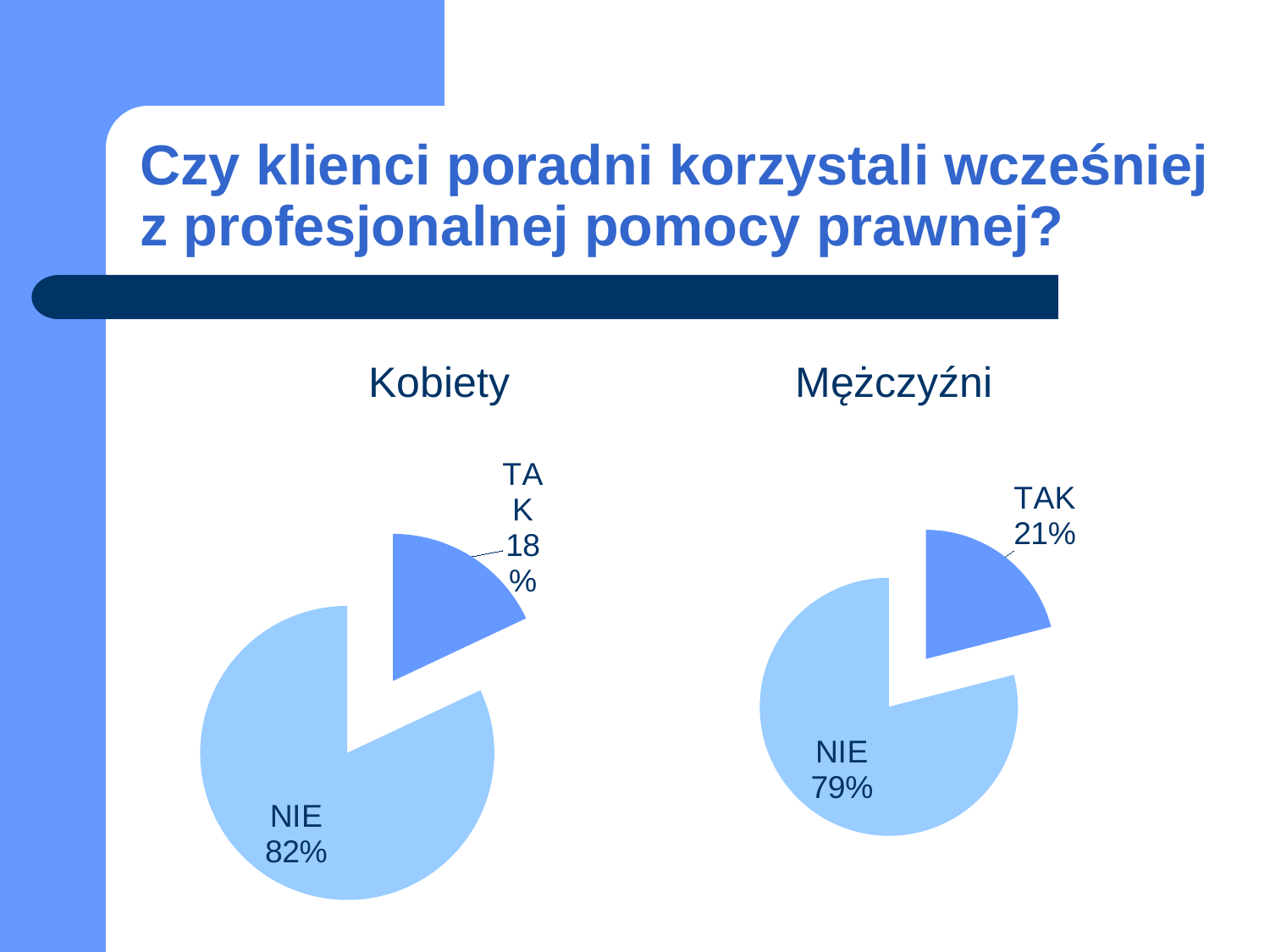
In the Mężczyźni chart, what share of the pie is labelled NIE? 79% In the Mężczyźni chart, what is the difference between the NIE and TAK shares? 58% What kind of chart is the Kobiety chart? Pie chart In the Kobiety chart, which slice is the largest? NIE In the Kobiety chart, what share of the pie is labelled NIE? 82% How many slices does the Mężczyźni chart have? 2 In the Mężczyźni chart, what share of the pie is labelled TAK? 21% Which is larger: the TAK share in the Kobiety chart or the TAK share in the Mężczyźni chart? Mężczyźni In the Mężczyźni chart, which slice is the smallest? TAK In the Kobiety chart, what is the difference between the NIE and TAK shares? 64% How many pie charts are shown on the slide? 2